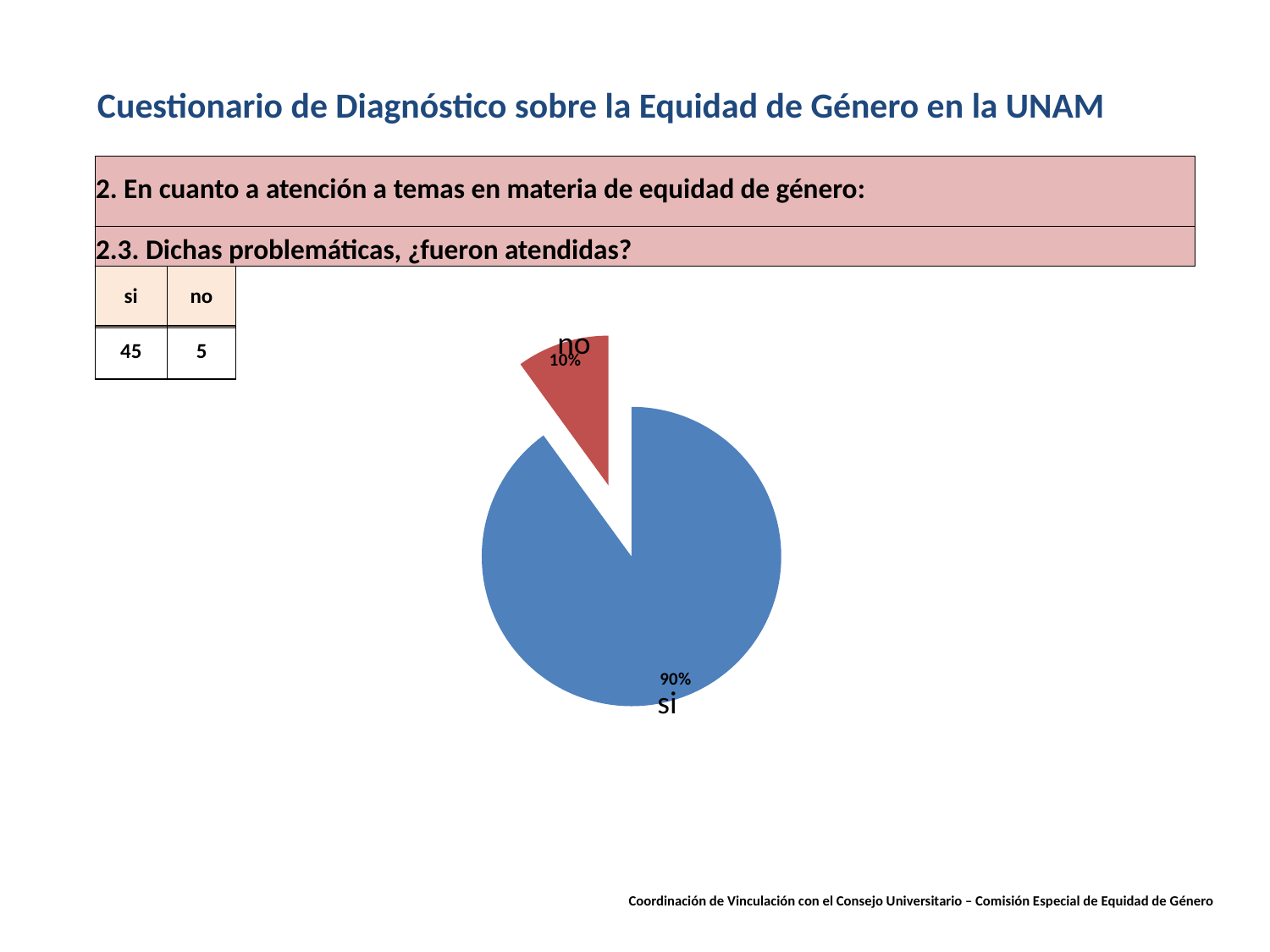
What kind of chart is shown on the slide? pie chart Which slice of the pie chart is the largest? si Which slice of the pie chart is the smallest? no What colour is the "no" slice in the pie chart? red How many slices does the pie chart have? 2 What percentage of the pie chart does the "si" slice represent? 90% Which is larger in the pie chart, the "si" slice or the "no" slice? si What is the difference in percentage points between the "si" slice and the "no" slice? 80 What colour is the "si" slice in the pie chart? blue What percentage of the pie chart does the "no" slice represent? 10%